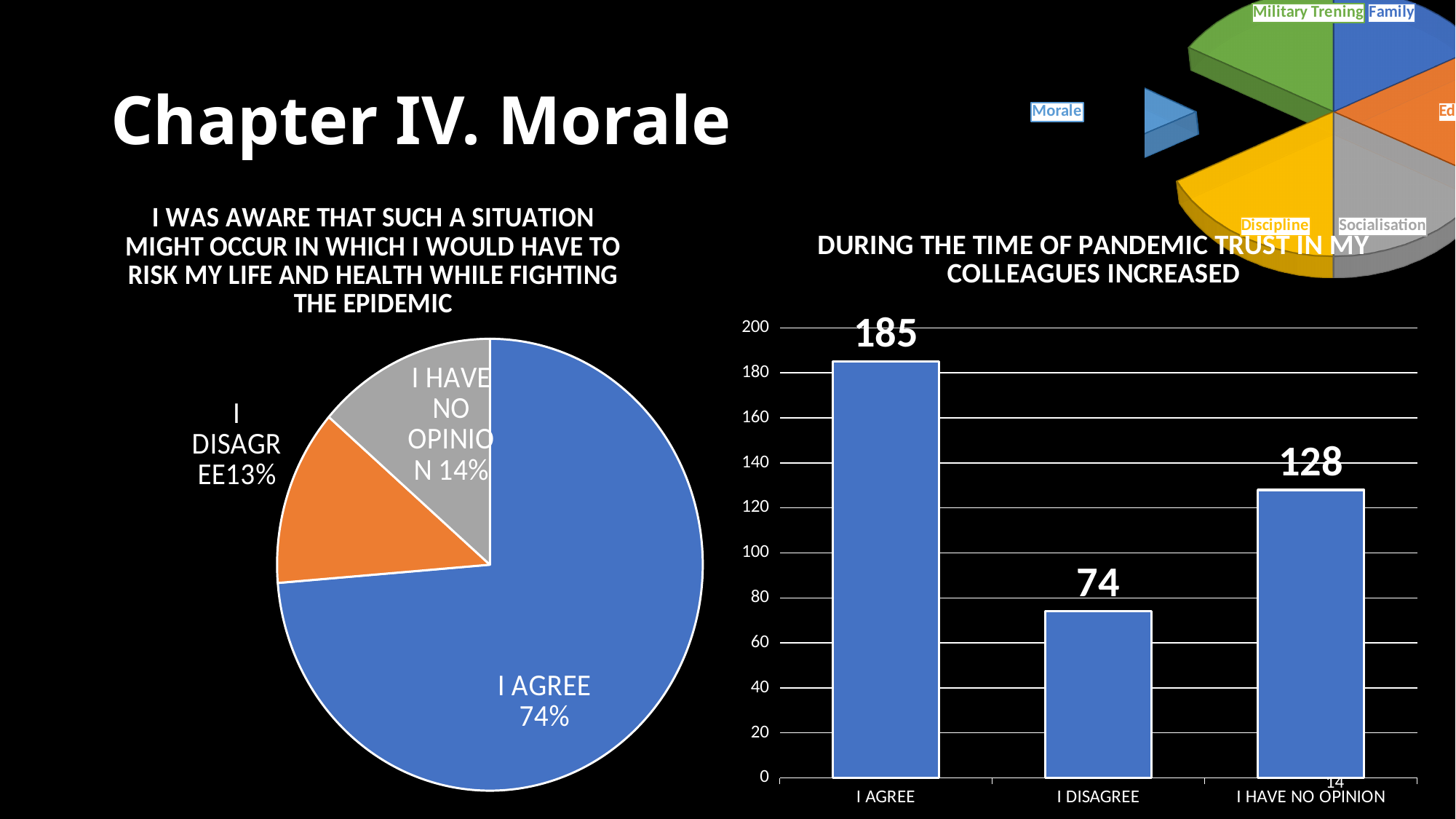
How many categories are shown in the bar chart on the right? 3 What kind of chart is the chart on the right of the slide? Bar chart In the bar chart on the right, which category has the highest value? I AGREE In the bar chart on the right, which is larger: the value for 'I HAVE NO OPINION' or the value for 'I DISAGREE'? I HAVE NO OPINION In the bar chart titled 'During the time of pandemic trust in my colleagues increased', what is the value for 'I AGREE'? 185 In the bar chart titled 'During the time of pandemic trust in my colleagues increased', what is the value for 'I DISAGREE'? 74 In the bar chart on the right, which category has the lowest value? I DISAGREE In the bar chart titled 'During the time of pandemic trust in my colleagues increased', what is the value for 'I HAVE NO OPINION'? 128 In the pie chart on the left, which slice is the smallest? I DISAGREE In the pie chart on the left, what share of responses is 'I HAVE NO OPINION'? 14% In the bar chart on the right, what is the difference between the values for 'I AGREE' and 'I HAVE NO OPINION'? 57 In the pie chart on the left, what share of responses is 'I AGREE'? 74%